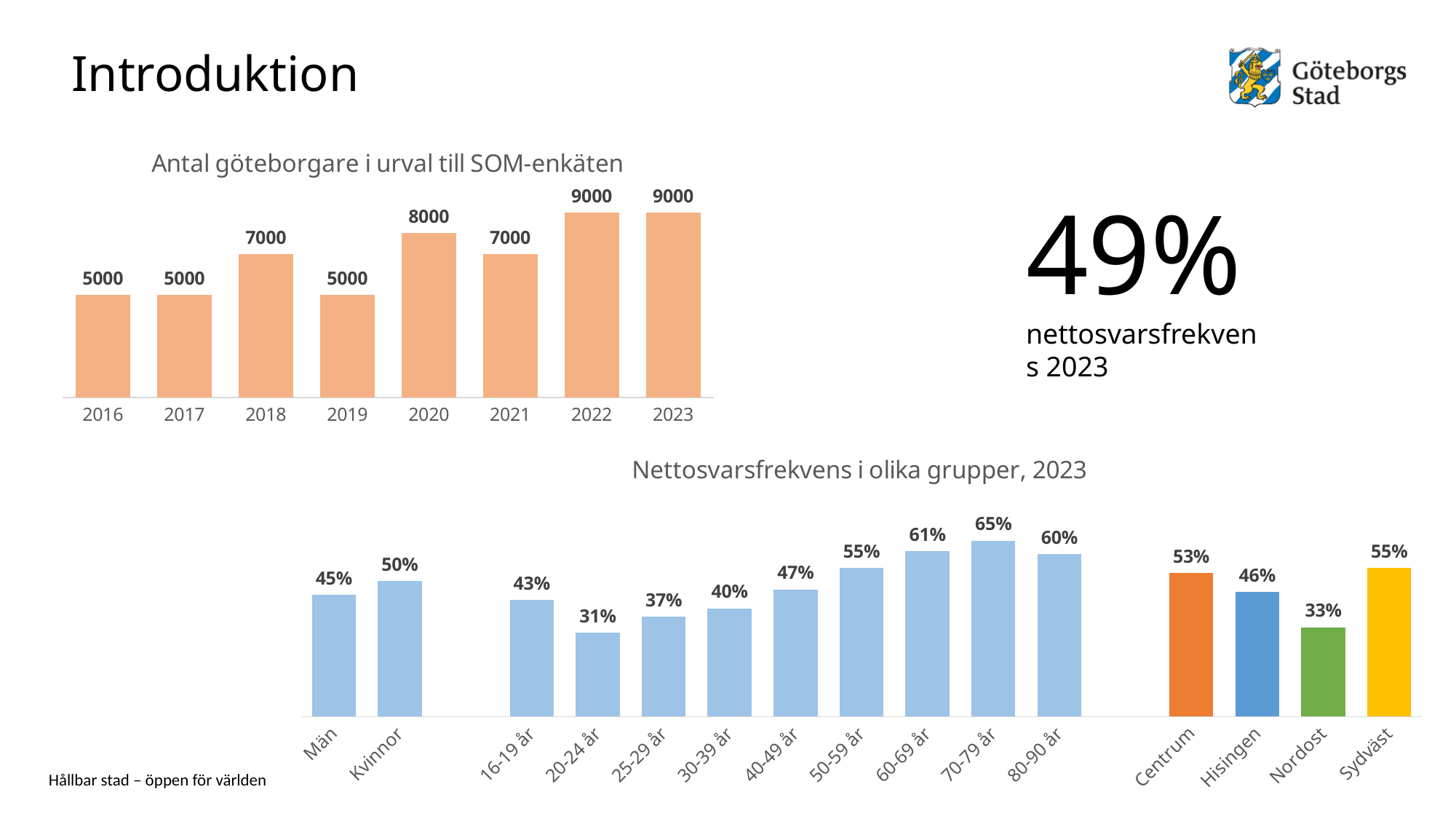
In the chart 'Nettosvarsfrekvens i olika grupper, 2023', how many bars are shown in total? 15 In the chart 'Antal göteborgare i urval till SOM-enkäten', what is the value for 2020? 8000 In the chart 'Nettosvarsfrekvens i olika grupper, 2023', which group has the highest value? 70-79 år In the chart 'Nettosvarsfrekvens i olika grupper, 2023', what is the difference between the values for Sydväst and Nordost? 22% In the chart 'Antal göteborgare i urval till SOM-enkäten', what is the difference between the values for 2023 and 2016? 4000 In the chart 'Nettosvarsfrekvens i olika grupper, 2023', which group has the lowest value? 20-24 år In the chart 'Nettosvarsfrekvens i olika grupper, 2023', which is larger, the value for Centrum or the value for Hisingen? Centrum In the chart 'Nettosvarsfrekvens i olika grupper, 2023', what colour is the bar for Nordost? green What kind of chart is 'Antal göteborgare i urval till SOM-enkäten'? bar chart In the chart 'Antal göteborgare i urval till SOM-enkäten', which years have the highest value? 2022 and 2023 In the chart 'Nettosvarsfrekvens i olika grupper, 2023', what is the value for Kvinnor? 50% In the chart 'Antal göteborgare i urval till SOM-enkäten', how many years are shown on the x axis? 8